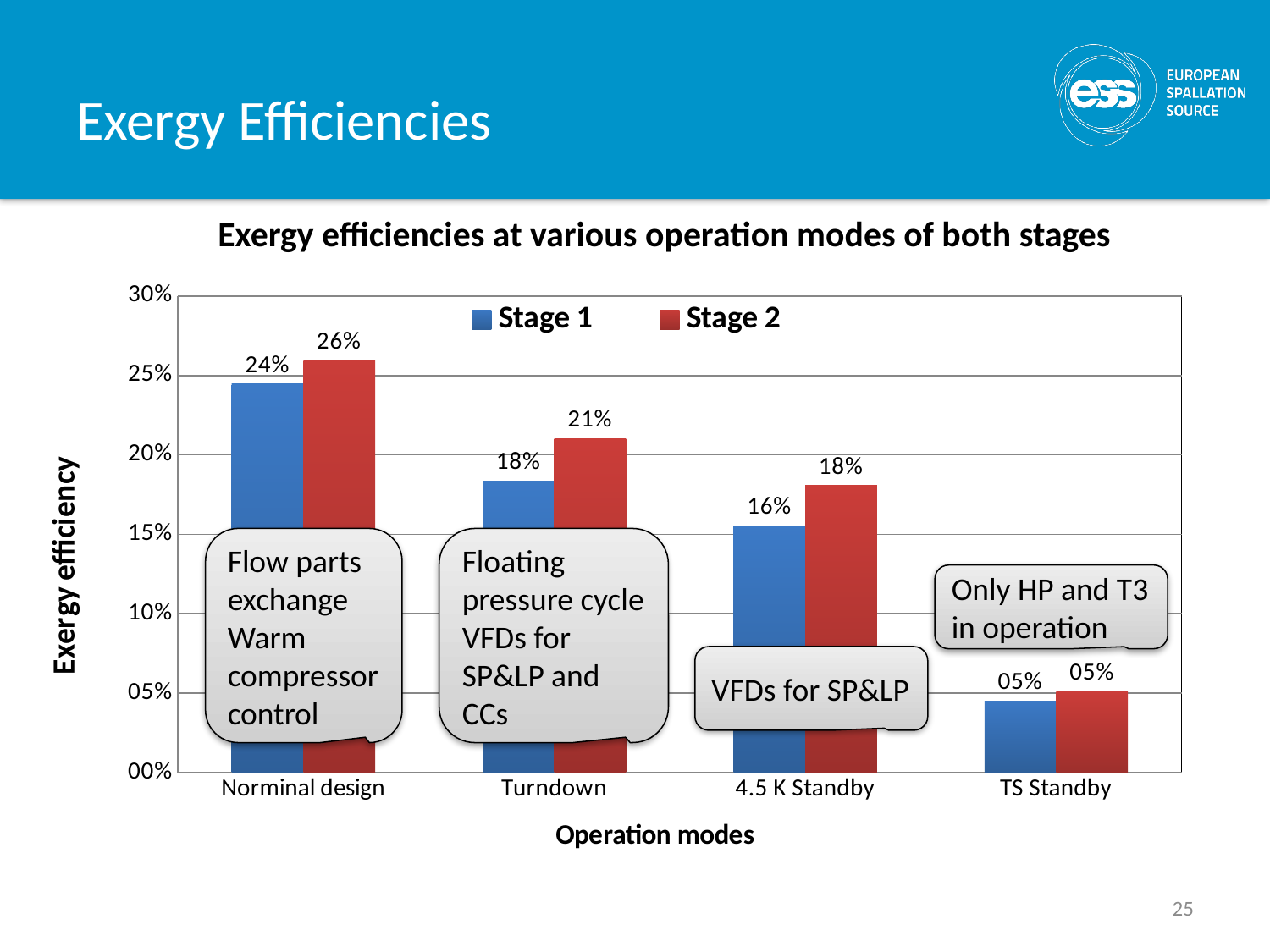
What is the Stage 1 exergy efficiency for 4.5 K Standby? 16% How many operation modes are shown on the x axis? 4 How many series does the legend list? 2 What is the Stage 2 exergy efficiency for TS Standby? 05% What kind of chart is shown on the slide? Bar chart What is the Stage 1 exergy efficiency for Norminal design? 24% What is the difference between the Stage 2 and Stage 1 exergy efficiencies for Turndown? 3% Which operation mode has the highest Stage 2 exergy efficiency? Norminal design Is the Stage 1 exergy efficiency for Norminal design greater or less than 20%? greater Which operation mode has the lowest Stage 1 exergy efficiency? TS Standby For 4.5 K Standby, which stage has the higher exergy efficiency? Stage 2 What is the Stage 2 exergy efficiency for Turndown? 21%